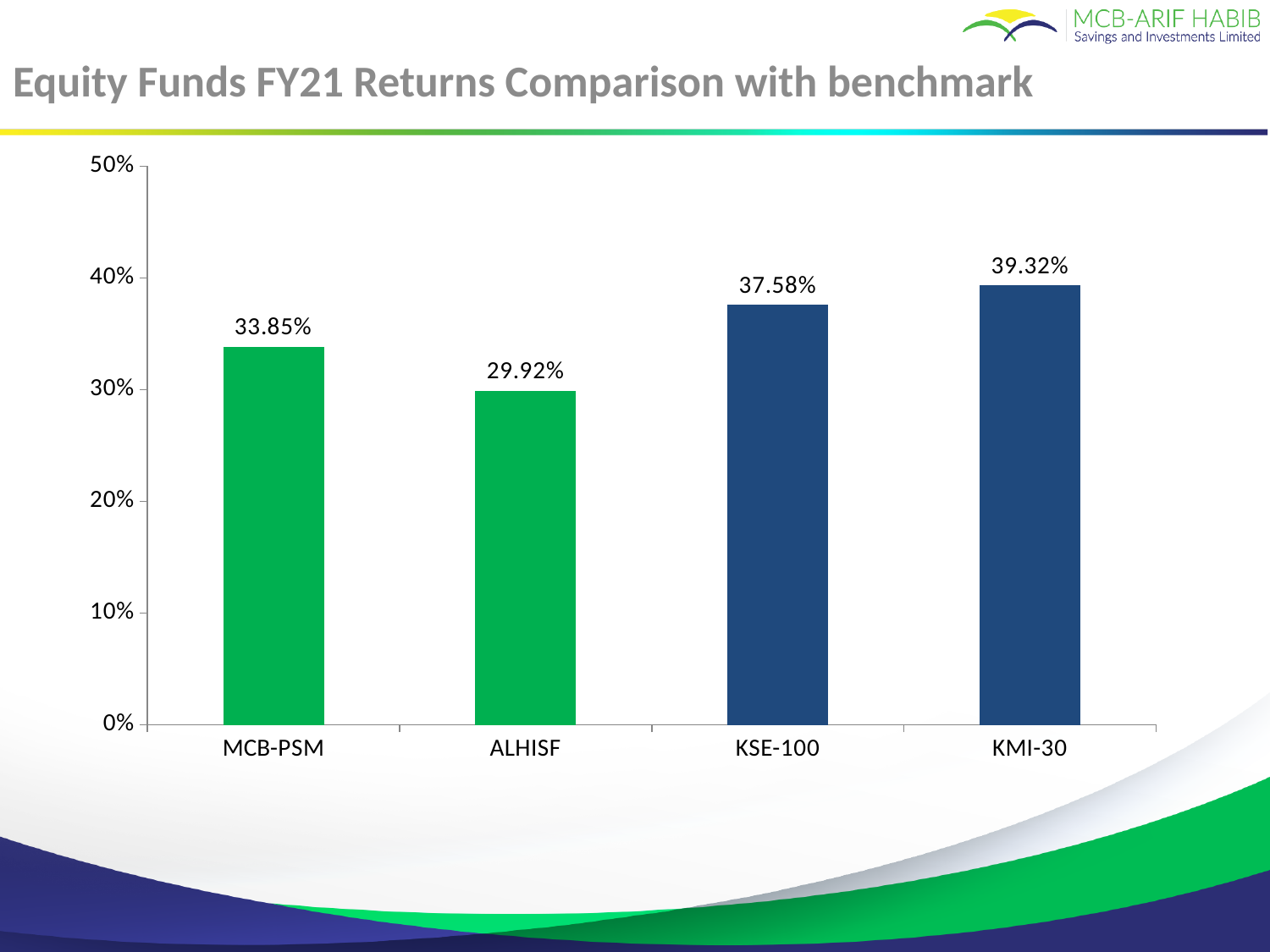
How many categories are shown on the x axis? 4 What is the value shown for KMI-30? 39.32% What is the difference between the KSE-100 value and the MCB-PSM value? 3.73% Which category has the lowest value? ALHISF What is the value shown for KSE-100? 37.58% What is the difference between the KMI-30 value and the ALHISF value? 9.40% Which category has the highest value? KMI-30 What kind of chart is shown on the slide? bar chart What is the FY21 return shown for MCB-PSM? 33.85% Is the value for ALHISF greater or less than 30%? less What is the FY21 return shown for ALHISF? 29.92% Which is larger, the value for MCB-PSM or the value for KSE-100? KSE-100